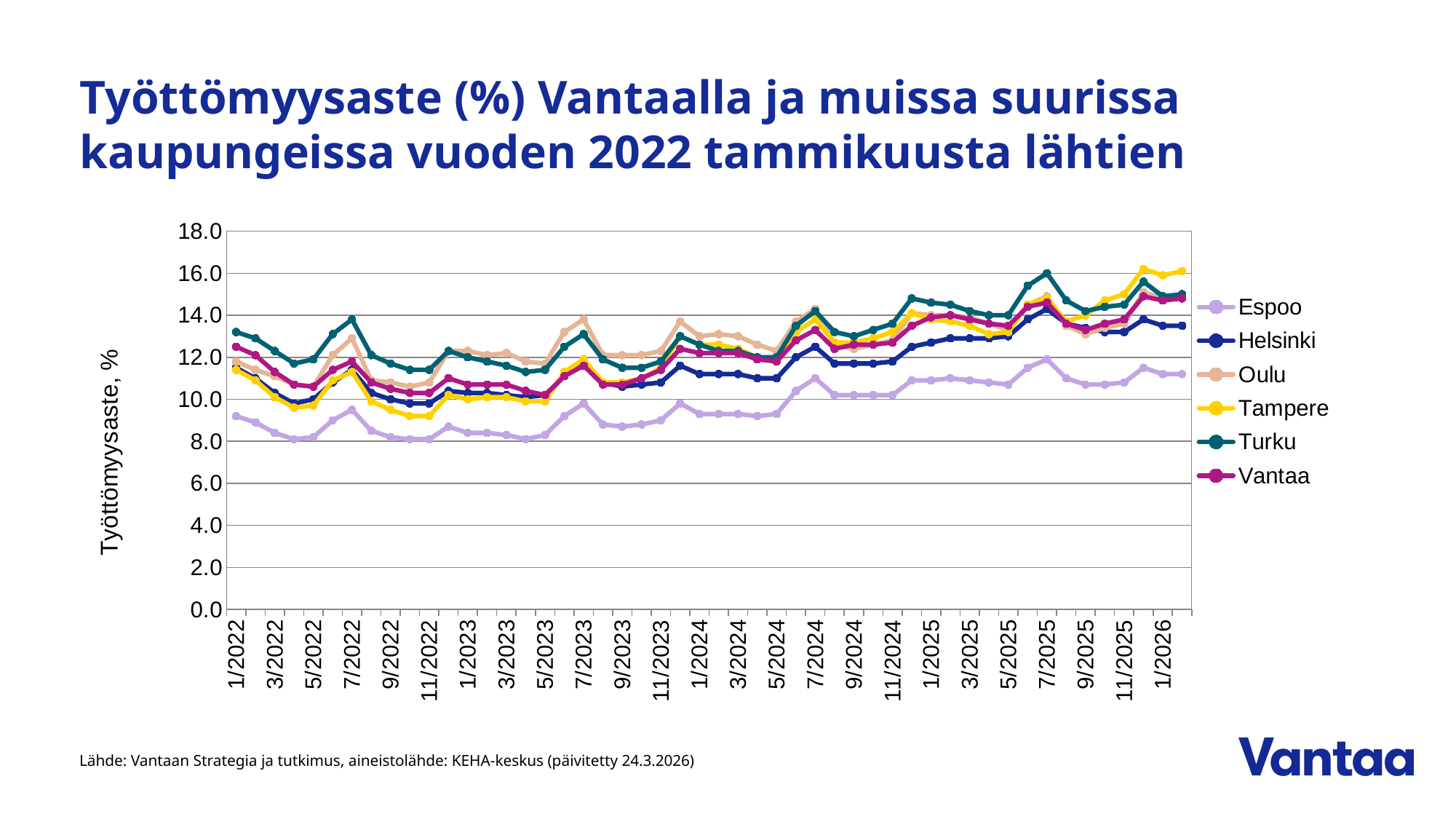
What is the label of the vertical axis? Työttömyysaste, % Is the value for Tampere at 1/2026 greater or less than 14? greater Does the unemployment rate for Espoo rise or fall overall from 1/2022 to 1/2026? rise Which city has the highest unemployment rate at 1/2026? Tampere How many series does the legend list? 6 What kind of chart is shown on the slide? line chart Which city has the lowest unemployment rate throughout the whole period shown? Espoo Is the value for Espoo at 1/2022 greater or less than 10? less At 1/2024, which is larger, the value for Helsinki or the value for Espoo? Helsinki Which city has the highest unemployment rate at 7/2025? Turku Which cities are listed in the chart legend? Espoo, Helsinki, Oulu, Tampere, Turku, Vantaa Is the value for Espoo at 1/2026 greater or less than 10? greater